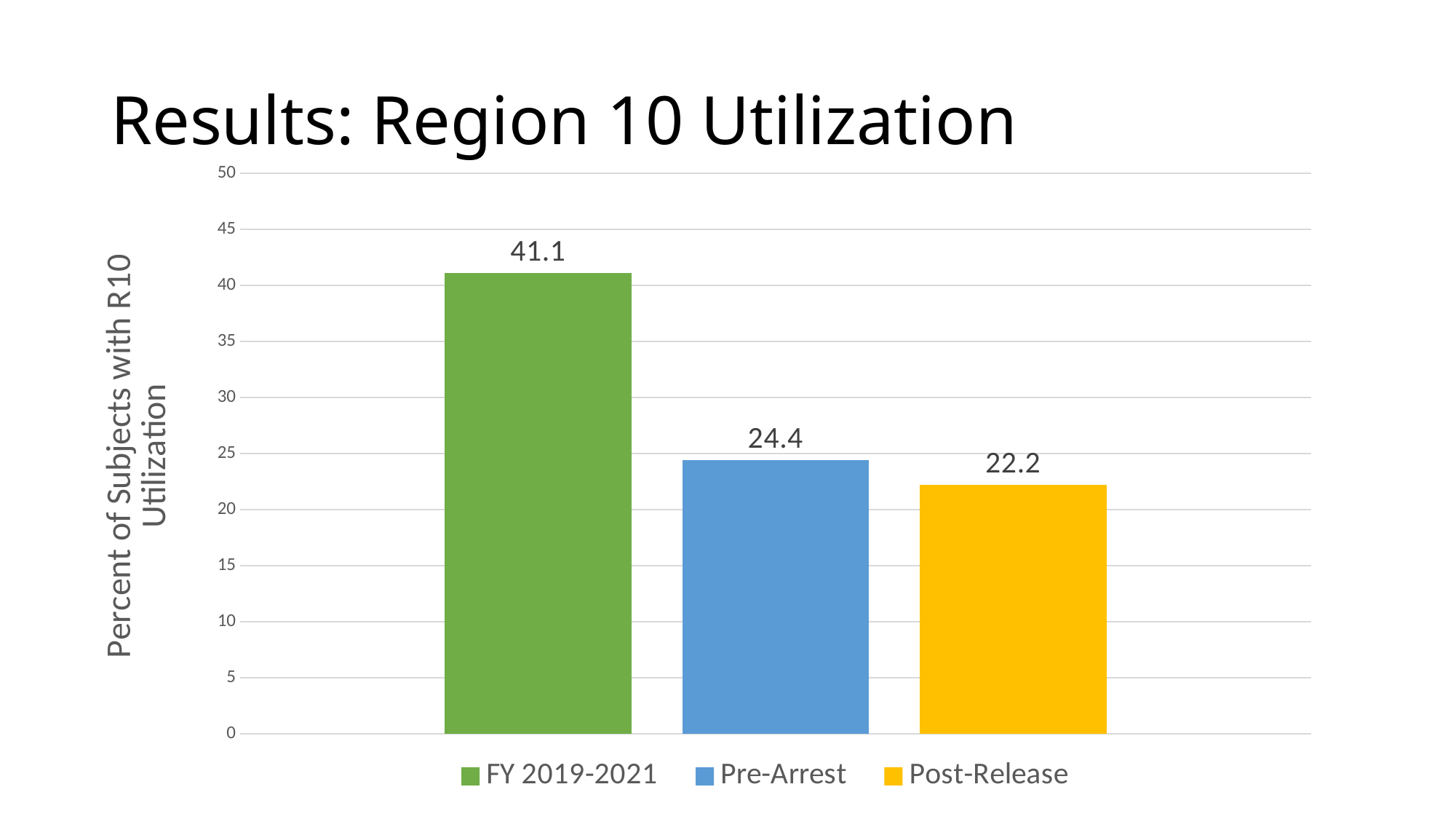
What is the difference between the FY 2019-2021 value and the Pre-Arrest value? 16.7 What is the difference between the Pre-Arrest value and the Post-Release value? 2.2 Which series has the highest value? FY 2019-2021 What is the value for Post-Release? 22.2 How many series does the legend list? 3 Which is larger, the value for FY 2019-2021 or the value for Post-Release? FY 2019-2021 What is the value for FY 2019-2021? 41.1 What kind of chart is shown on the slide? bar chart Is the value for Pre-Arrest greater or less than 25? less Which series has the lowest value? Post-Release What is the label on the vertical axis? Percent of Subjects with R10 Utilization What is the value for Pre-Arrest? 24.4